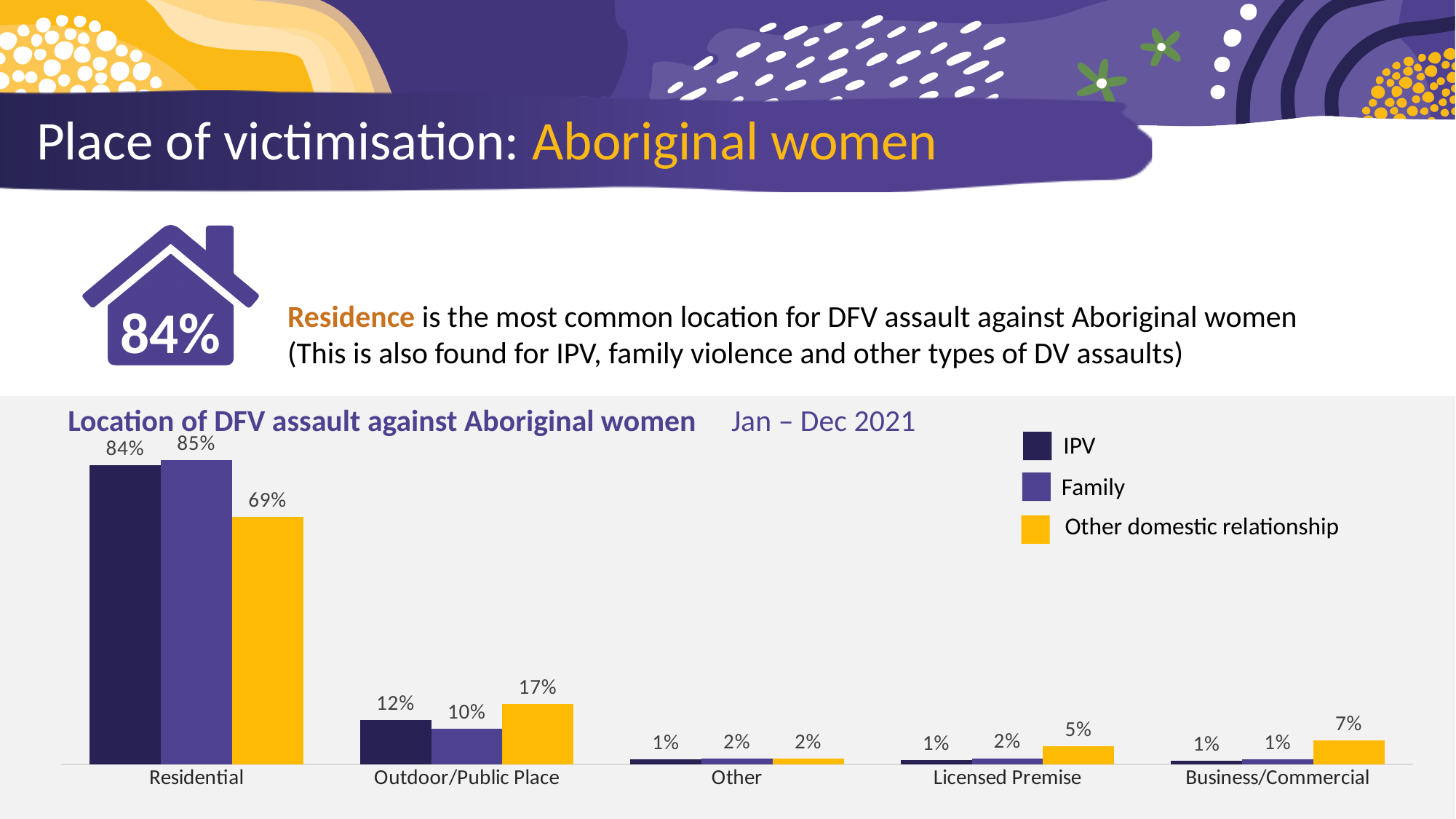
What is the difference between the Family and Other domestic relationship values for Residential? 16% What kind of chart is shown on the slide? Bar chart Which is larger for Outdoor/Public Place: the IPV value or the Other domestic relationship value? Other domestic relationship What is the Other domestic relationship value for Business/Commercial? 7% What is the IPV value for Residential? 84% Which location has the lowest IPV value? Other, Licensed Premise and Business/Commercial (all 1%) What is the Other domestic relationship value for Licensed Premise? 5% How many series does the legend list? 3 What is the Family value for Outdoor/Public Place? 10% How many location categories are shown on the x axis? 5 What time period does the chart cover? Jan – Dec 2021 Which location has the highest Other domestic relationship value? Residential